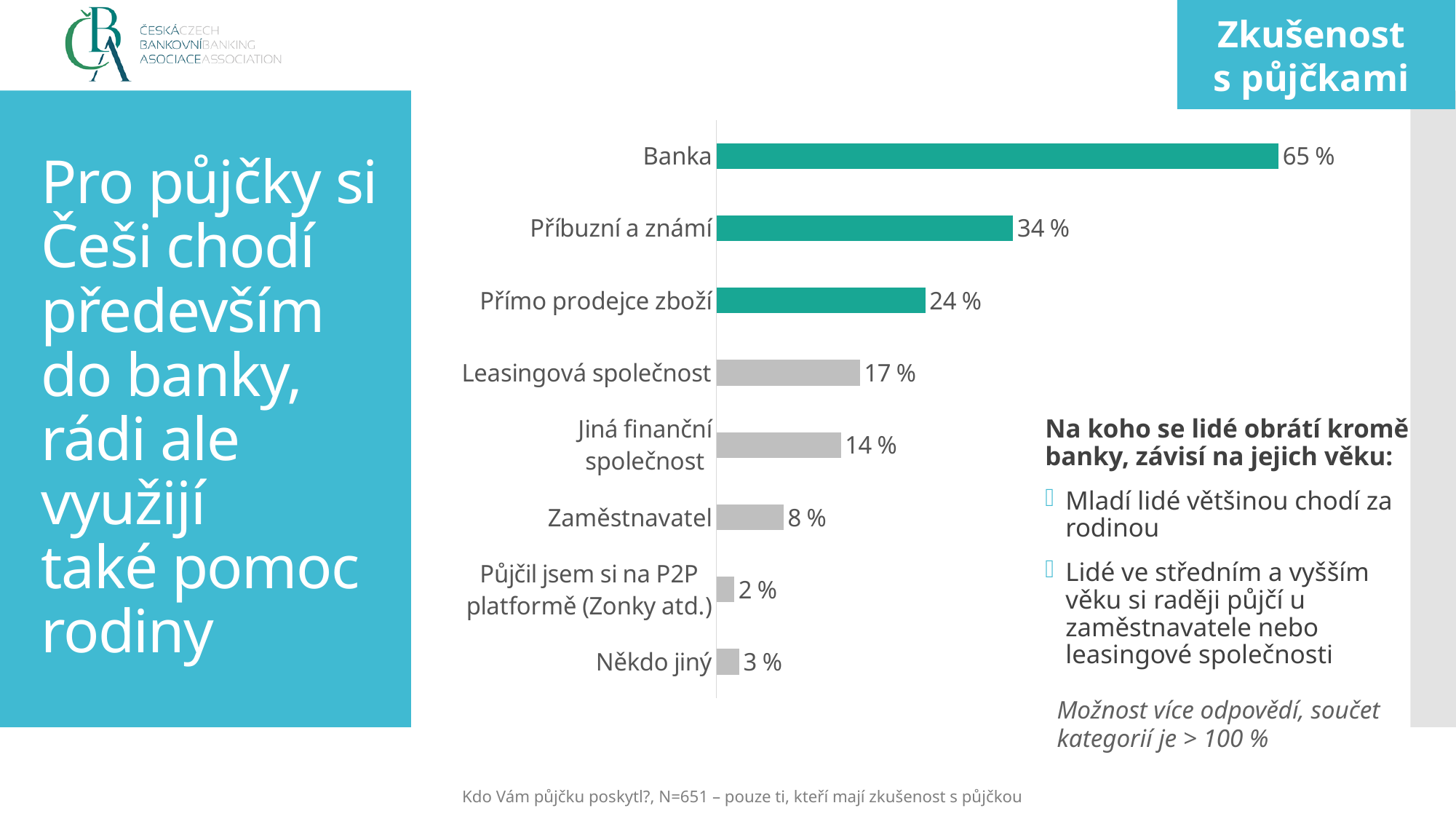
How many categories are shown in the chart? 8 How many bars in the chart are coloured teal rather than grey? 3 What is the difference between the values for Banka and Příbuzní a známí? 31 % Which category has the highest value? Banka What is the difference between the values for Přímo prodejce zboží and Zaměstnavatel? 16 % What kind of chart is shown on the slide? Bar chart What is the value for Příbuzní a známí? 34 % What is the value for Leasingová společnost? 17 % Which is larger, the value for Jiná finanční společnost or the value for Zaměstnavatel? Jiná finanční společnost Which category has the lowest value? Půjčil jsem si na P2P platformě (Zonky atd.) What is the value for Banka? 65 % What is the value for Půjčil jsem si na P2P platformě (Zonky atd.)? 2 %